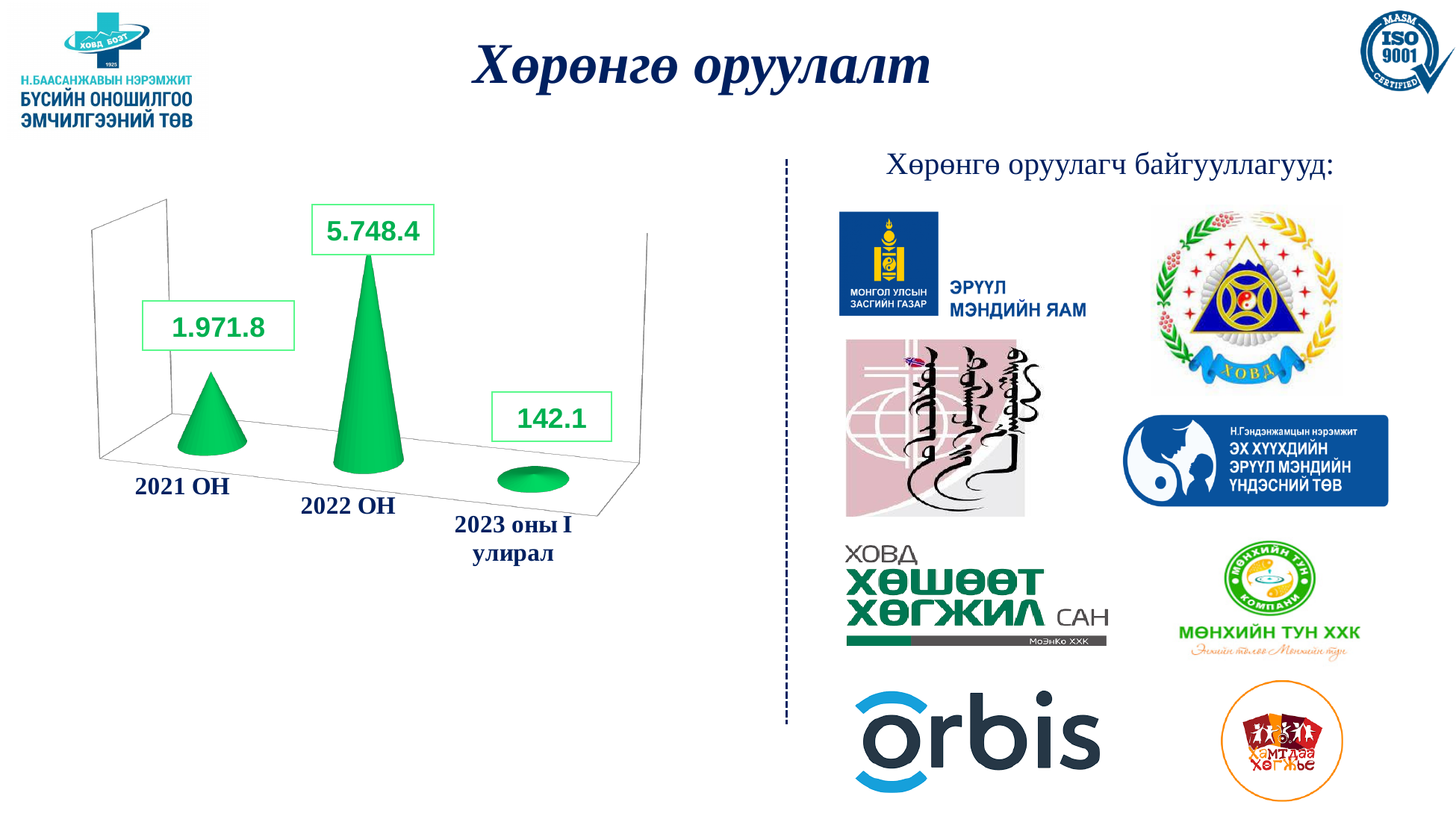
Which category has the highest value? 2022 ОН What is the title of the slide containing the chart? Хөрөнгө оруулалт What is the value shown for 2021 ОН? 1.971.8 Do the values rise or fall from 2021 ОН to 2022 ОН? rise Which is larger, the value for 2021 ОН or the value for 2023 оны I улирал? 2021 ОН How many categories are plotted in the chart? 3 What is the value shown for 2022 ОН? 5.748.4 What is the value shown for 2023 оны I улирал? 142.1 Which is larger, the value for 2021 ОН or the value for 2022 ОН? 2022 ОН What kind of chart is shown on the slide? bar chart (3D cones) Do the values rise or fall from 2022 ОН to 2023 оны I улирал? fall Which category has the lowest value? 2023 оны I улирал